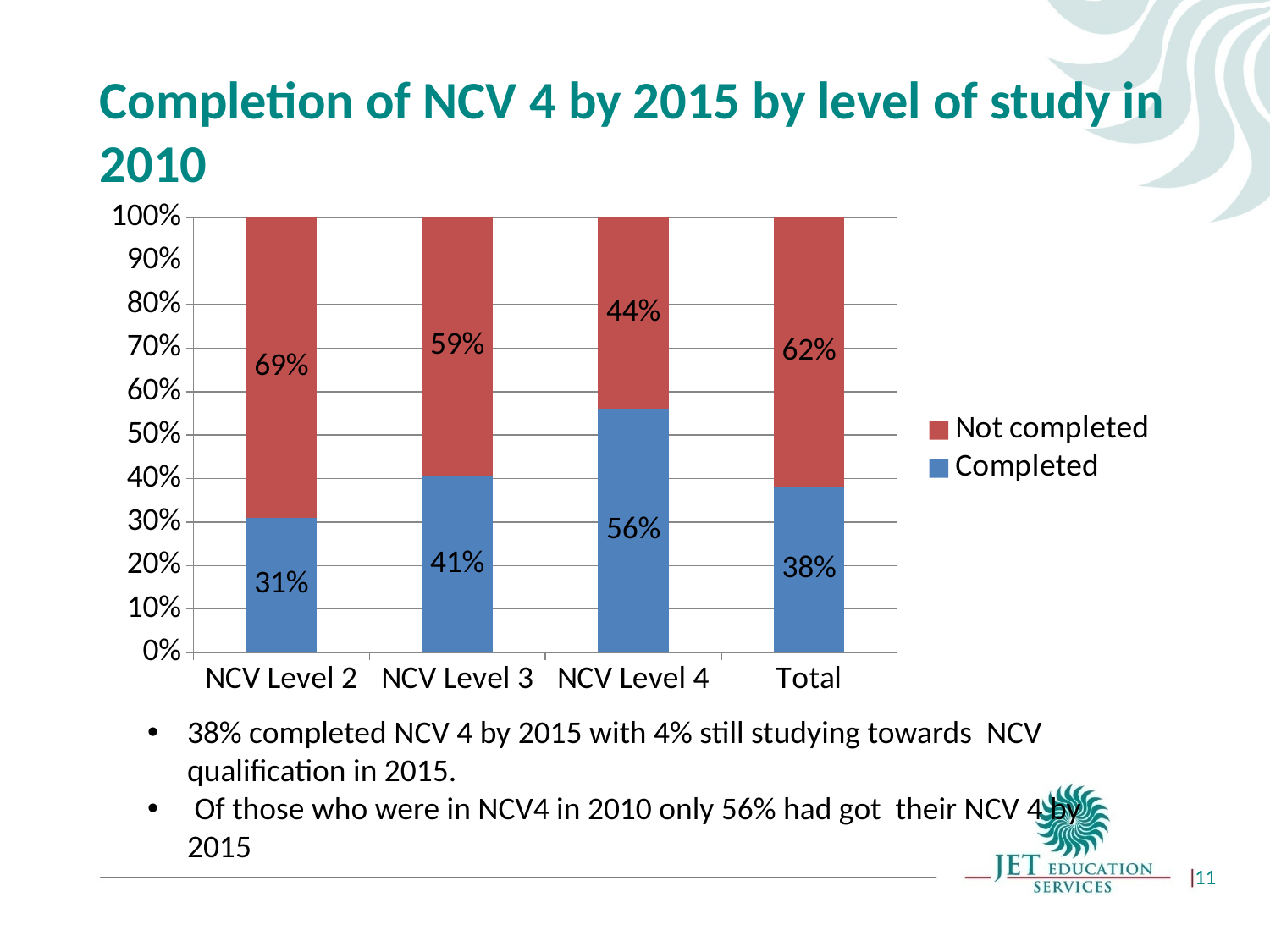
What percentage of NCV Level 2 students had completed NCV 4? 31% What is the total of the stacked bar for NCV Level 4? 100% What is the Not completed value for NCV Level 3? 59% Which is larger, the Not completed value for NCV Level 2 or for NCV Level 4? NCV Level 2 How many categories are shown on the x axis? 4 Which category has the lowest Completed percentage? NCV Level 2 Which category has the highest Completed percentage? NCV Level 4 What is the Completed value for the Total category? 38% How many series does the legend list? 2 What kind of chart is shown on the slide? Stacked bar chart Which colour represents the Completed series? Blue What is the difference between the Completed values for NCV Level 4 and NCV Level 2? 25%